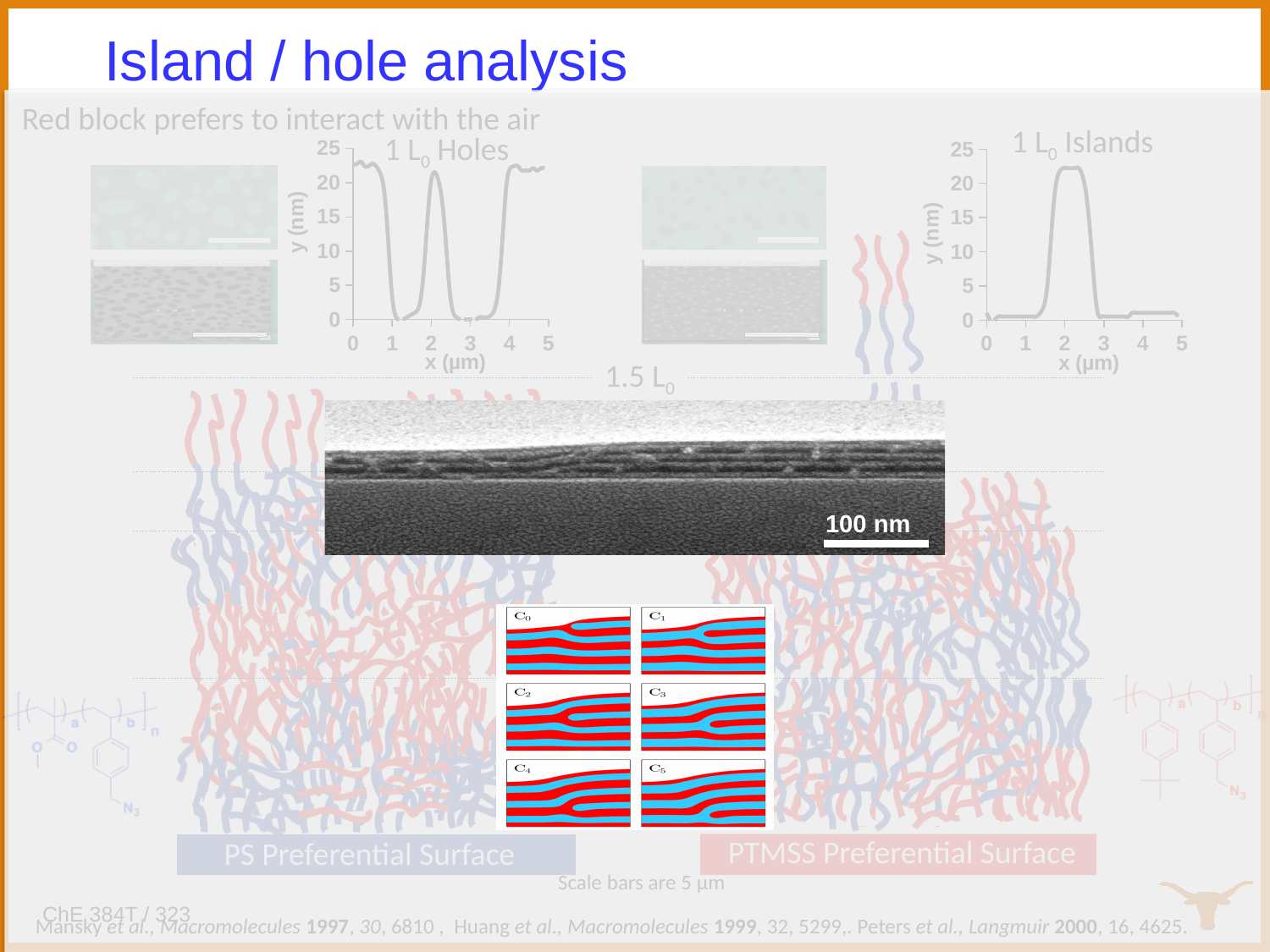
In the "1 L0 Islands" chart, is the value at x = 0.5 μm larger or smaller than the value at x = 2.5 μm? smaller In the "1 L0 Holes" chart, is the value at x = 3 μm greater or less than 10 nm? less In the "1 L0 Holes" chart, does the value rise or fall between x = 0.5 μm and x = 1 μm? fall How many line charts are shown on the slide? 2 In the "1 L0 Islands" chart, does the value rise or fall between x = 1.5 μm and x = 2 μm? rise In the "1 L0 Islands" chart, what is the label of the x axis? x (μm) In the "1 L0 Holes" chart, is the value at x = 0.5 μm greater or less than 10 nm? greater What kind of chart is the "1 L0 Holes" chart? line chart In the "1 L0 Holes" chart, what is the label of the y axis? y (nm) In the "1 L0 Islands" chart, is the value at x = 4 μm greater or less than 5 nm? less What kind of chart is the "1 L0 Islands" chart? line chart